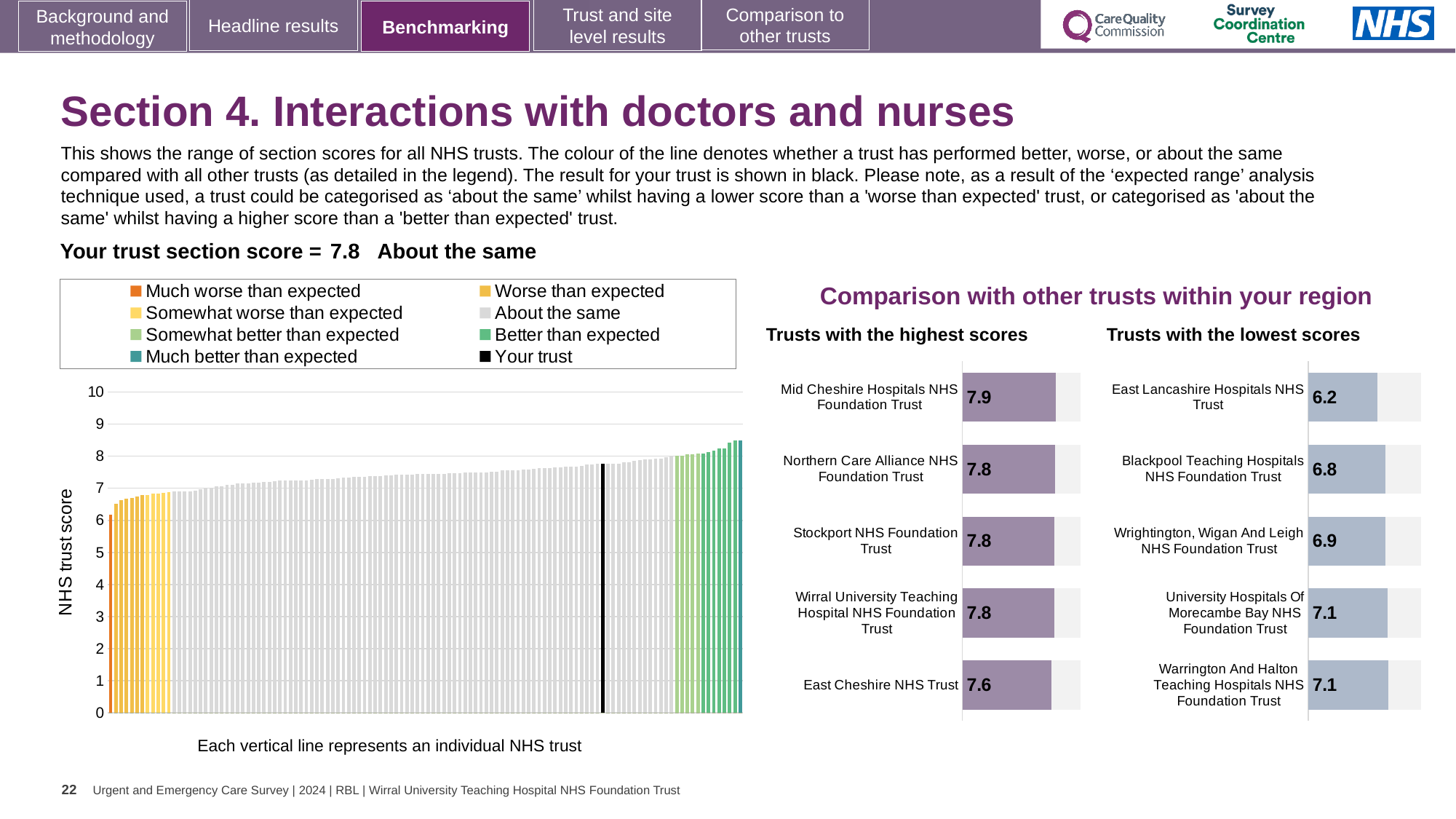
In the 'Trusts with the highest scores' chart, which trust has the highest score? Mid Cheshire Hospitals NHS Foundation Trust How many trusts are shown in the 'Trusts with the lowest scores' chart? 5 In the 'Trusts with the highest scores' chart, what is the score for East Cheshire NHS Trust? 7.6 In the 'Trusts with the lowest scores' chart, what is the difference between the scores of Blackpool Teaching Hospitals NHS Foundation Trust and East Lancashire Hospitals NHS Trust? 0.6 In the 'Trusts with the lowest scores' chart, what is the score for Blackpool Teaching Hospitals NHS Foundation Trust? 6.8 In the 'Trusts with the lowest scores' chart, what is the score for East Lancashire Hospitals NHS Trust? 6.2 In the 'Trusts with the lowest scores' chart, which trust has the lowest score? East Lancashire Hospitals NHS Trust How many entries does the legend of the main 'NHS trust score' chart list? 8 In the main 'NHS trust score' chart, do the bar heights rise or fall from left to right? rise In the 'Trusts with the highest scores' chart, what is the score for Mid Cheshire Hospitals NHS Foundation Trust? 7.9 In the 'Trusts with the highest scores' chart, what is the difference between the scores of Mid Cheshire Hospitals NHS Foundation Trust and East Cheshire NHS Trust? 0.3 In the 'Trusts with the lowest scores' chart, which has the higher score: Blackpool Teaching Hospitals NHS Foundation Trust or Wrightington, Wigan And Leigh NHS Foundation Trust? Wrightington, Wigan And Leigh NHS Foundation Trust